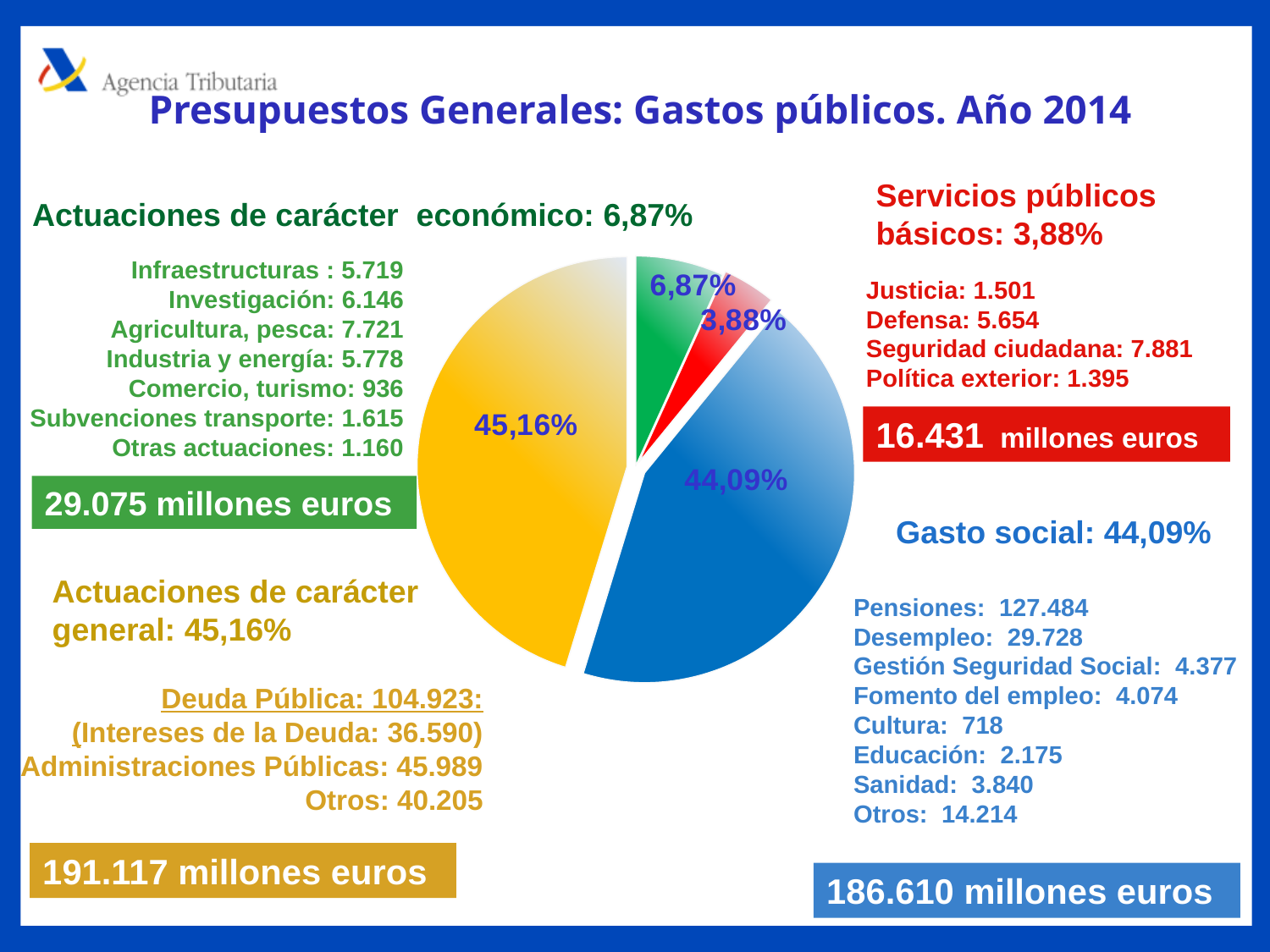
How many slices does the pie chart have? 4 What share of the pie does the red slice (Servicios públicos básicos) represent? 3,88% What is the combined share of the green (6,87%) and red (3,88%) slices? 10,75% What share of the pie does the green slice (Actuaciones de carácter económico) represent? 6,87% What share of the pie does the yellow slice (Actuaciones de carácter general) represent? 45,16% What kind of chart is shown on the slide? pie chart What is the difference in percentage points between the yellow slice (45,16%) and the blue slice (44,09%)? 1,07 What is the title of the slide containing the pie chart? Presupuestos Generales: Gastos públicos. Año 2014 Which category has the smallest slice of the pie? Servicios públicos básicos Which category has the largest slice of the pie? Actuaciones de carácter general Which is larger in the pie chart: the green slice (6,87%) or the red slice (3,88%)? the green slice (6,87%)